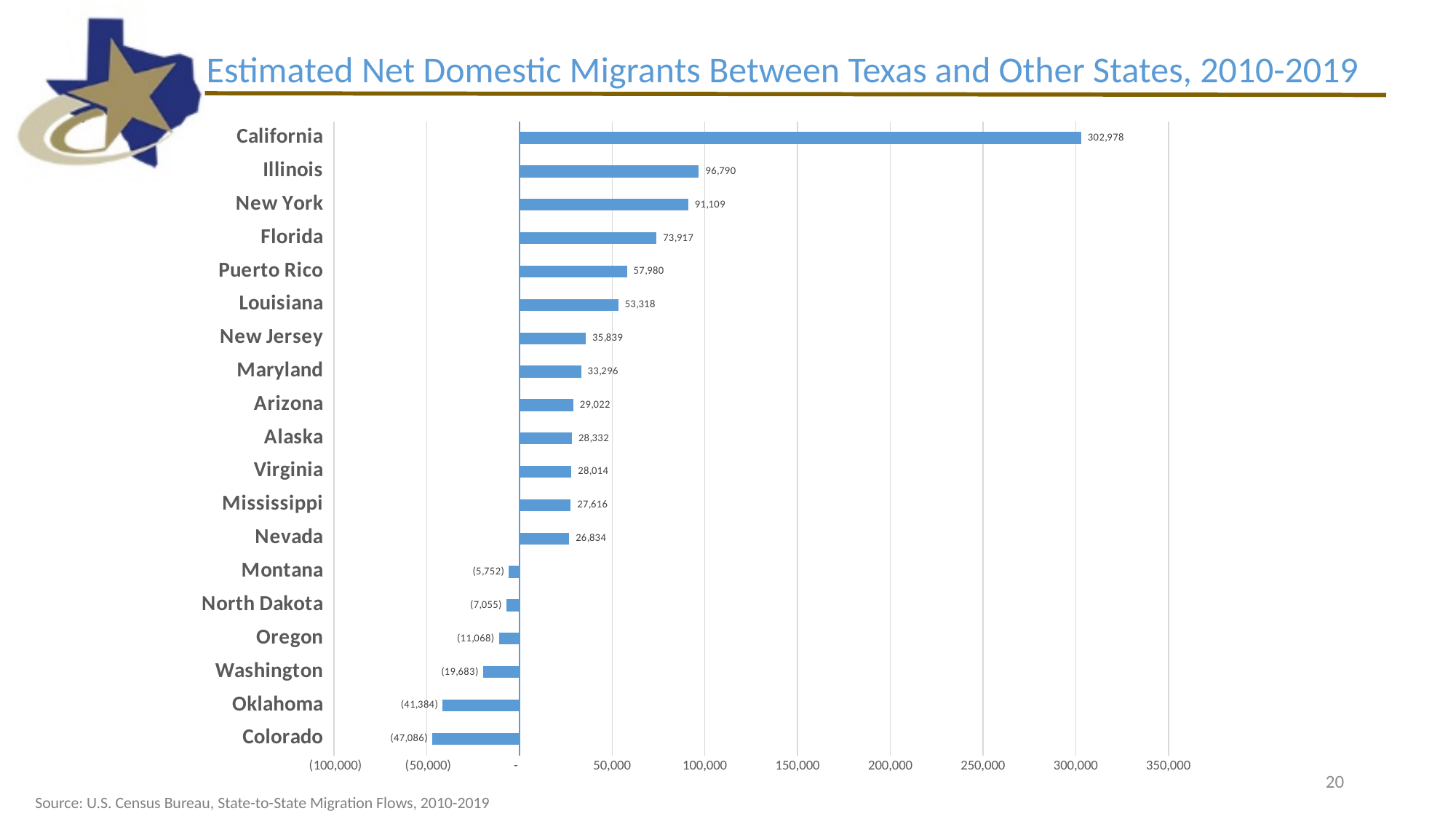
What is the estimated net domestic migration value shown for California? 302,978 What value is shown for Puerto Rico? 57,980 Which state has the lowest (most negative) value on the chart? Colorado Which state has the highest net domestic migration value on the chart? California What is the title of the chart? Estimated Net Domestic Migrants Between Texas and Other States, 2010-2019 Which has the larger value, Louisiana or Puerto Rico? Puerto Rico What kind of chart is shown on the slide? Bar chart What is the difference between the values for Florida and Puerto Rico? 15,937 How many states or territories are listed on the chart? 19 What value is shown for Colorado? (47,086) Is the value for California greater or less than 300,000? greater What is the difference between the values for Illinois and New York? 5,681